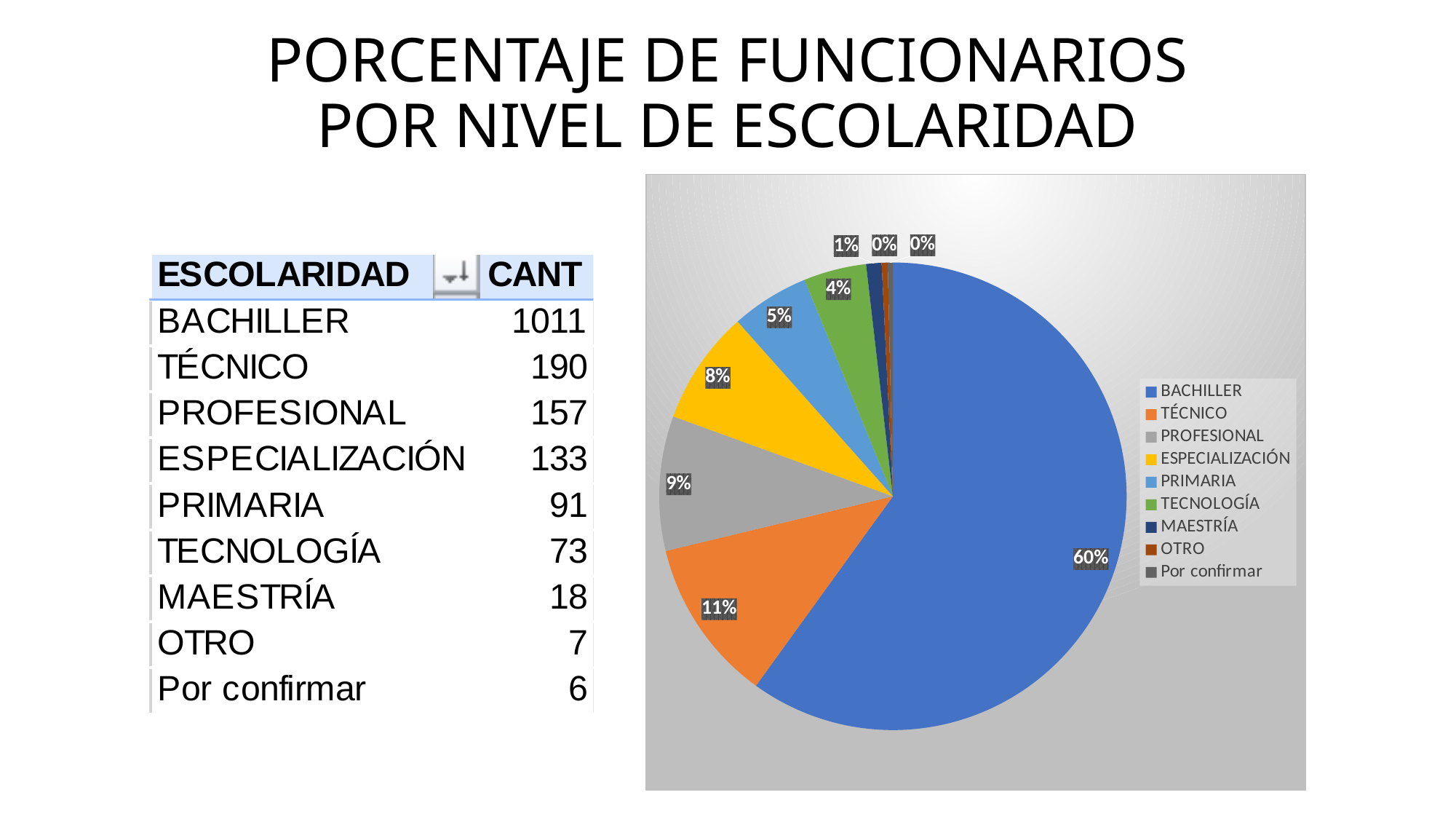
How many categories does the legend of the pie chart list? 9 What share of the pie does ESPECIALIZACIÓN represent? 8% What share of the pie does TÉCNICO represent? 11% Which slice is larger, TÉCNICO or PROFESIONAL? TÉCNICO What colour is the BACHILLER slice in the pie chart? blue What type of chart is shown on the slide? pie chart What share of the pie does PROFESIONAL represent? 9% What is the difference in percentage points between the BACHILLER slice and the TÉCNICO slice? 49 Which category has the largest slice of the pie? BACHILLER